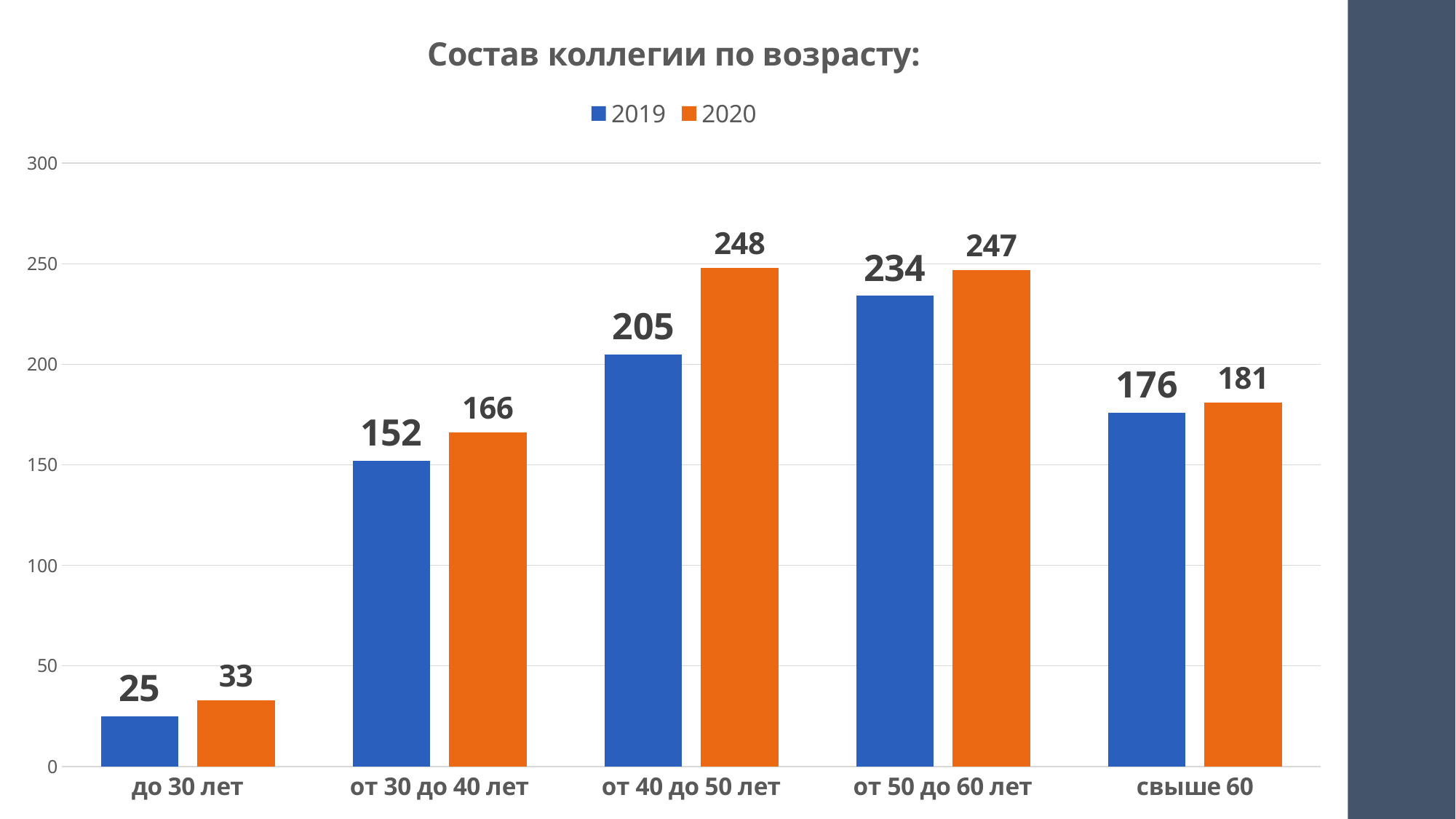
What is the difference between the 2020 and 2019 values for "от 30 до 40 лет"? 14 Which category has the lowest value for 2019? до 30 лет What is the title of the chart? Состав коллегии по возрасту: How many age categories are shown on the x axis? 5 What kind of chart is shown on the slide? bar chart What is the value for 2019 in the "от 40 до 50 лет" category? 205 What is the value for 2020 in the "до 30 лет" category? 33 Which category has the highest value for 2020? от 40 до 50 лет Is the 2019 value for "свыше 60" greater or less than 200? less Which is larger: the 2019 value for "от 50 до 60 лет" or the 2019 value for "от 40 до 50 лет"? от 50 до 60 лет How many series does the legend list? 2 What is the value for 2020 in the "свыше 60" category? 181